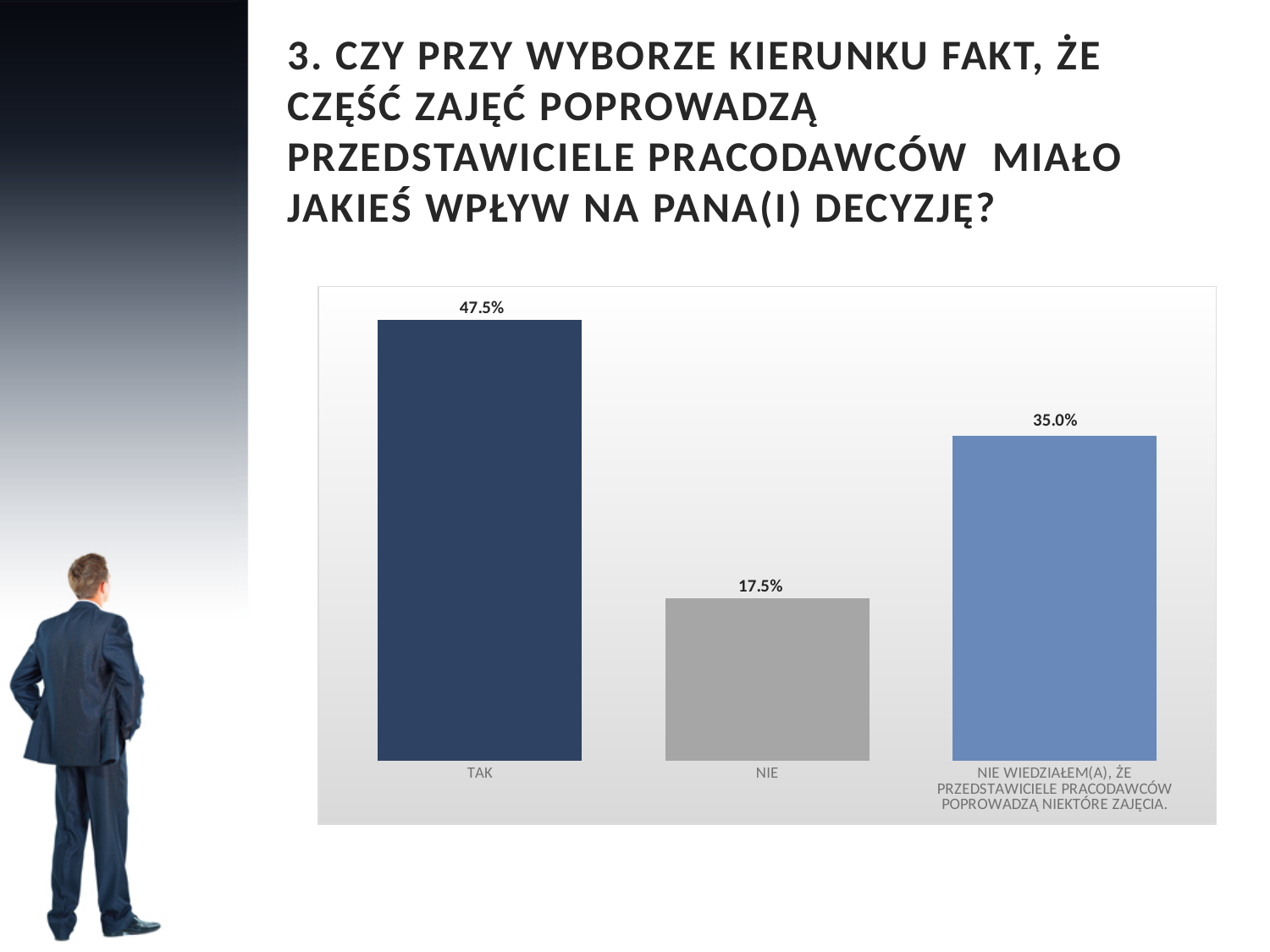
What is the difference between the values for TAK and NIE? 30.0% How many categories are shown in the chart? 3 What is the total of the three values shown in the chart? 100.0% What is the value for NIE? 17.5% What colour is the bar for NIE? Grey Which category has the lowest value? NIE What is the value for the category 'NIE WIEDZIAŁEM(A), ŻE PRZEDSTAWICIELE PRACODAWCÓW POPROWADZĄ NIEKTÓRE ZAJĘCIA.'? 35.0% What is the value for TAK? 47.5% What kind of chart is shown on the slide? Bar chart Which is larger, the value for NIE or the value for 'NIE WIEDZIAŁEM(A), ŻE PRZEDSTAWICIELE PRACODAWCÓW POPROWADZĄ NIEKTÓRE ZAJĘCIA.'? NIE WIEDZIAŁEM(A), ŻE PRZEDSTAWICIELE PRACODAWCÓW POPROWADZĄ NIEKTÓRE ZAJĘCIA. Which category has the highest value? TAK What is the difference between the values for TAK and 'NIE WIEDZIAŁEM(A), ŻE PRZEDSTAWICIELE PRACODAWCÓW POPROWADZĄ NIEKTÓRE ZAJĘCIA.'? 12.5%